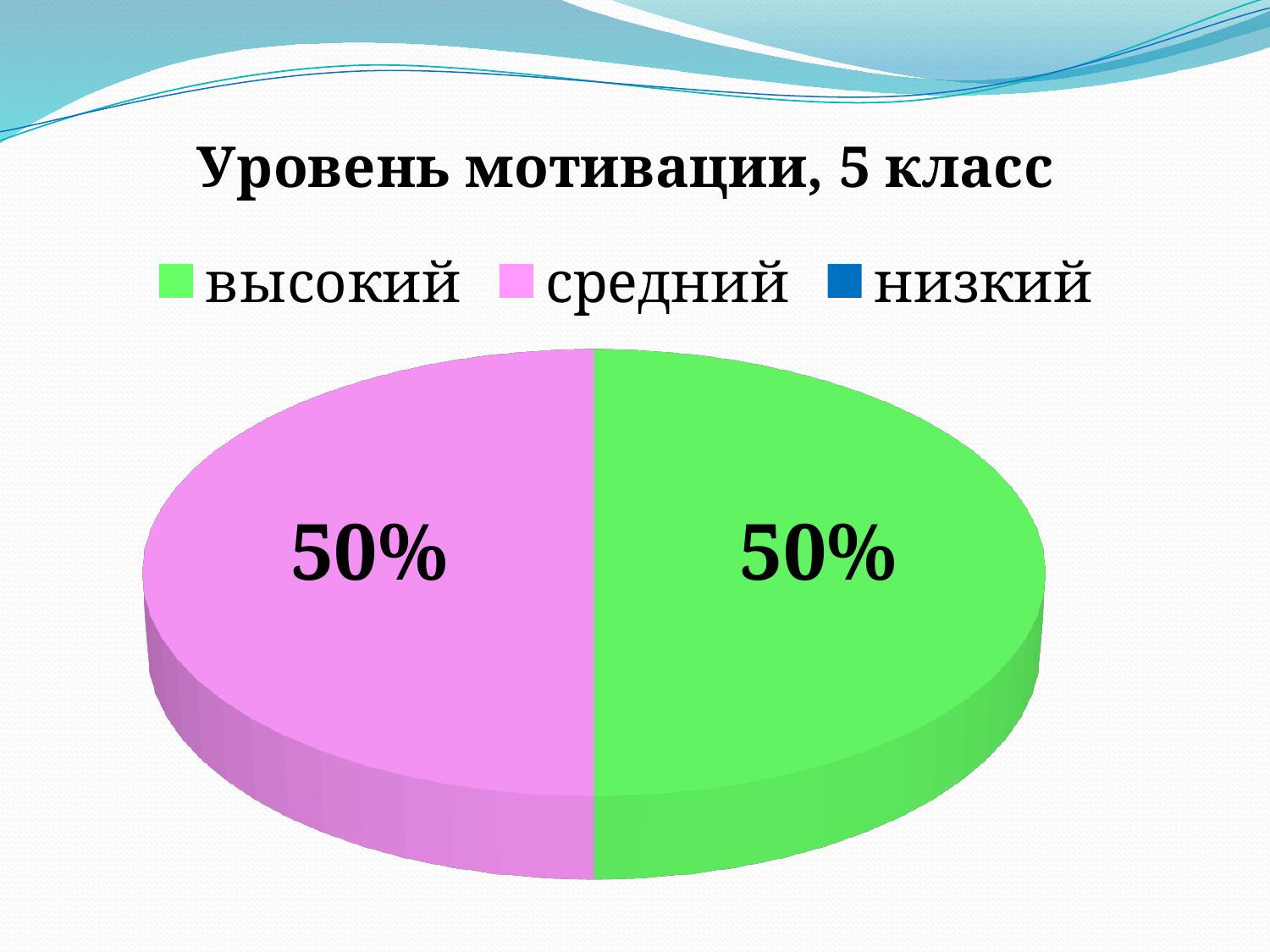
What share of the pie does the 'средний' slice take? 50% How many slices with data labels are visible in the pie? 2 Is the share for 'высокий' greater or less than 40%? greater What is the difference between the shares of 'высокий' and 'средний'? 0% What type of chart is shown on the slide? pie chart What share of the pie does the 'высокий' slice take? 50% Is the share for 'средний' greater or less than 60%? less What value is labelled on the pink slice? 50% What is the title of the chart? Уровень мотивации, 5 класс Which colour represents 'средний' in the legend? pink How many entries does the legend list? 3 What value is labelled on the green slice? 50%